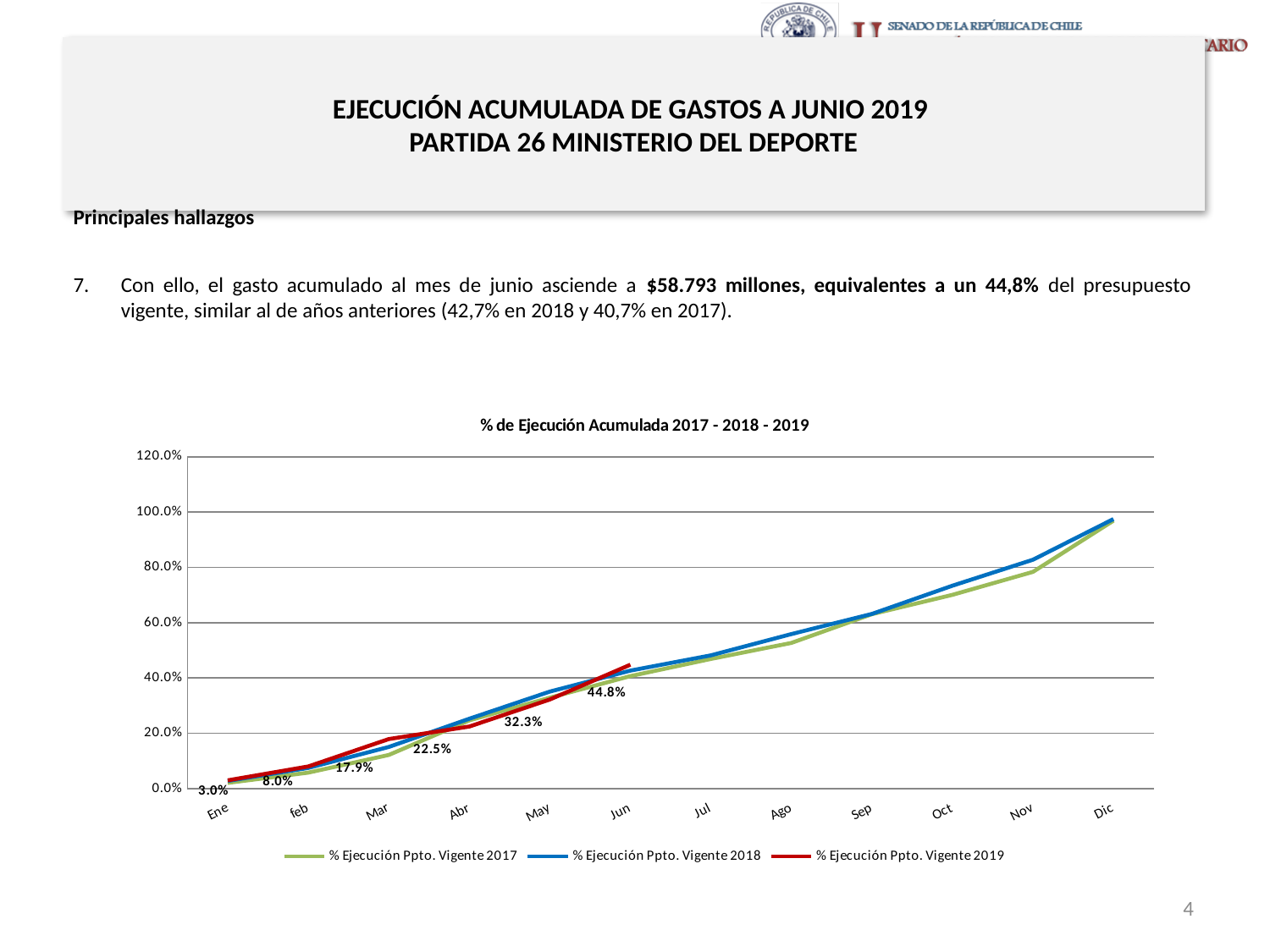
What is the value of the % Ejecución Ppto. Vigente 2019 series for Jun? 44.8% What is the value of the % Ejecución Ppto. Vigente 2019 series for Ene? 3.0% What kind of chart is shown on the slide? Line chart What is the value of the % Ejecución Ppto. Vigente 2019 series for Mar? 17.9% In the 2019 series, which is larger: the value for Mar or the value for Abr? Abr Is the value of the % Ejecución Ppto. Vigente 2017 series for Jul greater or less than 60.0%? less How many series does the chart legend list? 3 How many months are shown on the x axis of the chart? 12 What is the difference between the 2019 values for Jun and May? 12.5% Which month has the lowest value in the % Ejecución Ppto. Vigente 2019 series? Ene Which month has the highest value in the % Ejecución Ppto. Vigente 2019 series? Jun Is the value of the % Ejecución Ppto. Vigente 2018 series for Dic greater or less than 80.0%? greater